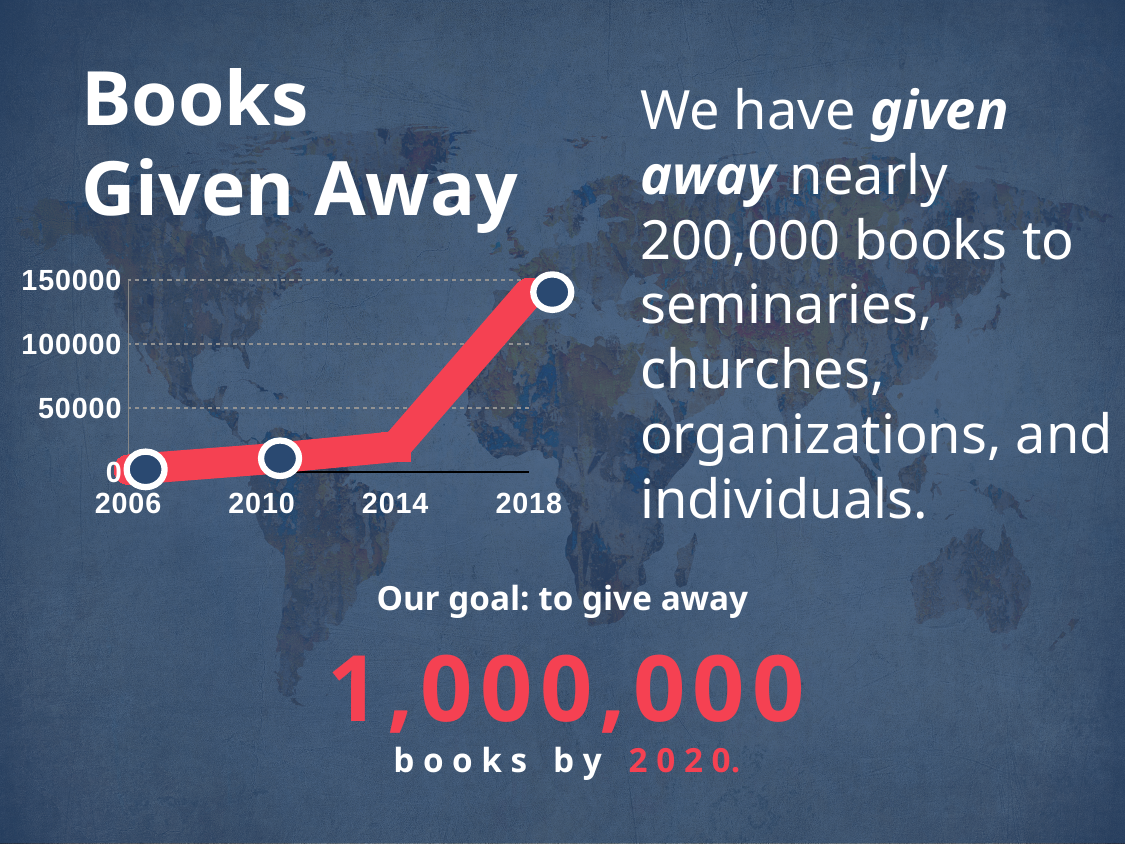
Which year has the highest value on the chart? 2018 Do the values rise or fall from 2006 to 2018? rise Is the value for 2006 greater or less than 50000? less What is the title of the chart? Books Given Away What kind of chart is shown on the slide? line chart Is the value for 2010 greater or less than 50000? less How many years are labelled on the x axis of the chart? 4 What is the highest value labelled on the y axis of the chart? 150000 Which is larger, the value for 2010 or the value for 2018? 2018 Is the value for 2018 greater or less than 100000? greater